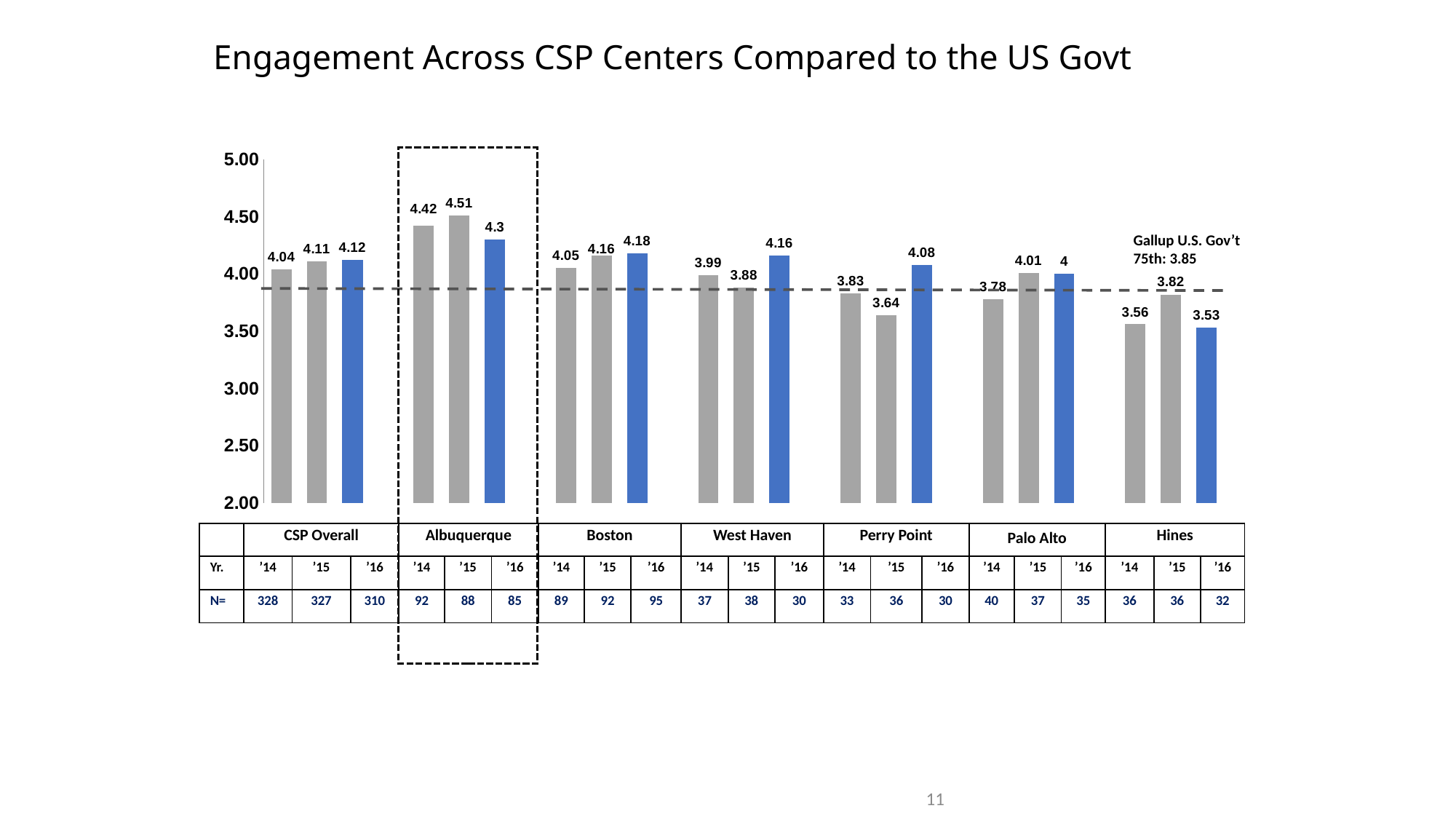
What kind of chart is shown on the slide? bar chart Which center and year has the lowest engagement value on the chart? Hines '16 What is the difference between the West Haven '16 value and the West Haven '15 value? 0.28 What is the engagement value for Hines in '16? 3.53 Is the value for Perry Point '15 greater or less than 4.00? less Do the values for Boston rise or fall from '14 to '16? rise Which center and year has the highest engagement value on the chart? Albuquerque '15 Which is larger, the Boston '16 value or the Palo Alto '16 value? Boston '16 What is the engagement value for Albuquerque in '15? 4.51 What is the engagement value for CSP Overall in '14? 4.04 How many CSP center groups (including CSP Overall) are shown on the chart? 7 What value does the dashed Gallup U.S. Gov't 75th percentile line represent? 3.85